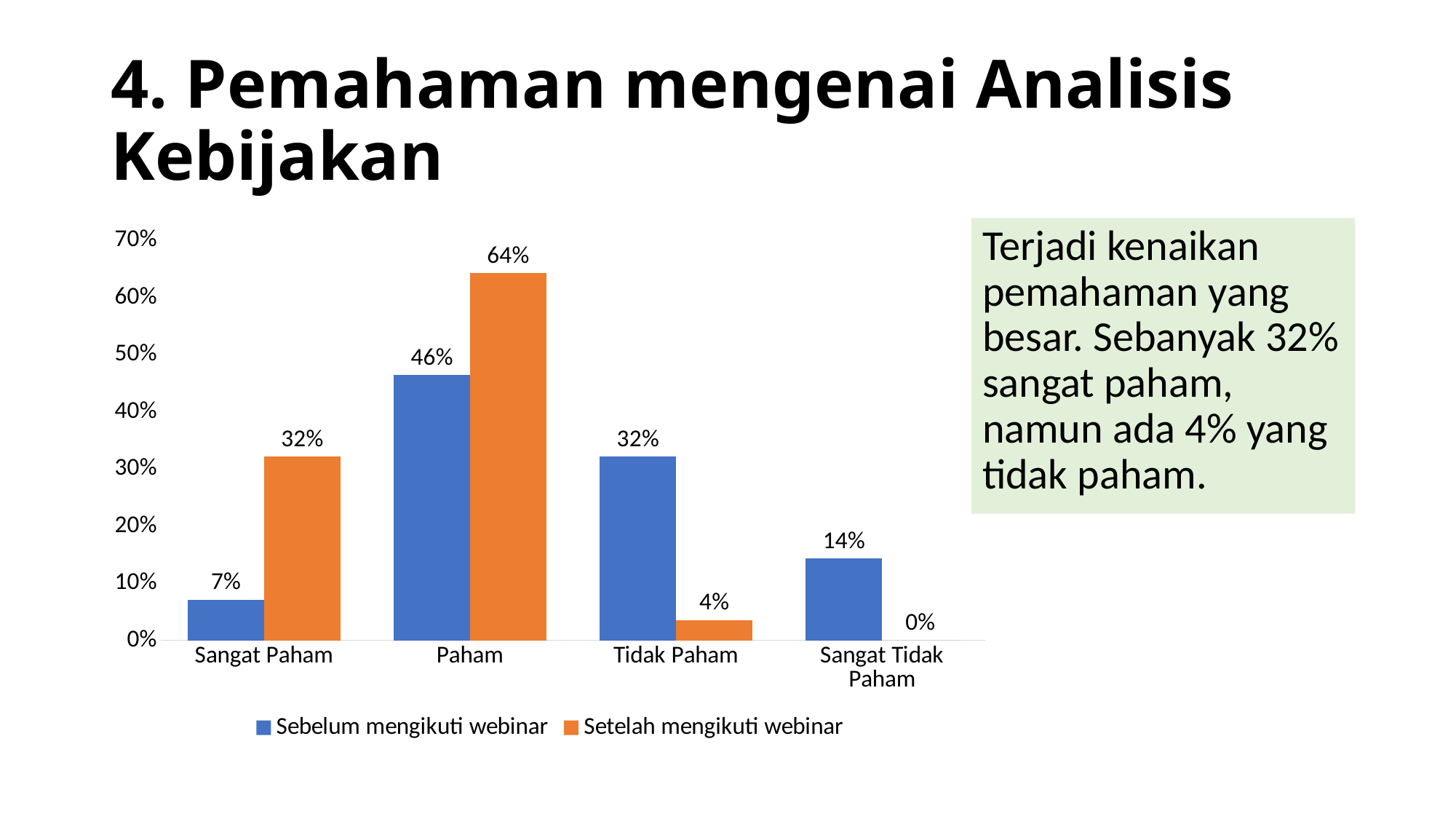
What is the value for Sangat Paham in the Sebelum mengikuti webinar series? 7% For Tidak Paham, which series has the larger value, Sebelum mengikuti webinar or Setelah mengikuti webinar? Sebelum mengikuti webinar Which category has the lowest value in the Sebelum mengikuti webinar series? Sangat Paham What kind of chart is shown on the slide? Bar chart What is the value for Paham in the Setelah mengikuti webinar series? 64% What is the value for Tidak Paham in the Sebelum mengikuti webinar series? 32% Which category has the highest value in the Setelah mengikuti webinar series? Paham What is the value for Sangat Tidak Paham in the Setelah mengikuti webinar series? 0% How many categories are shown on the x axis? 4 How many series does the legend list? 2 What is the difference between the Setelah and Sebelum values for Sangat Paham? 25% Is the Setelah mengikuti webinar value for Paham greater or less than 60%? greater